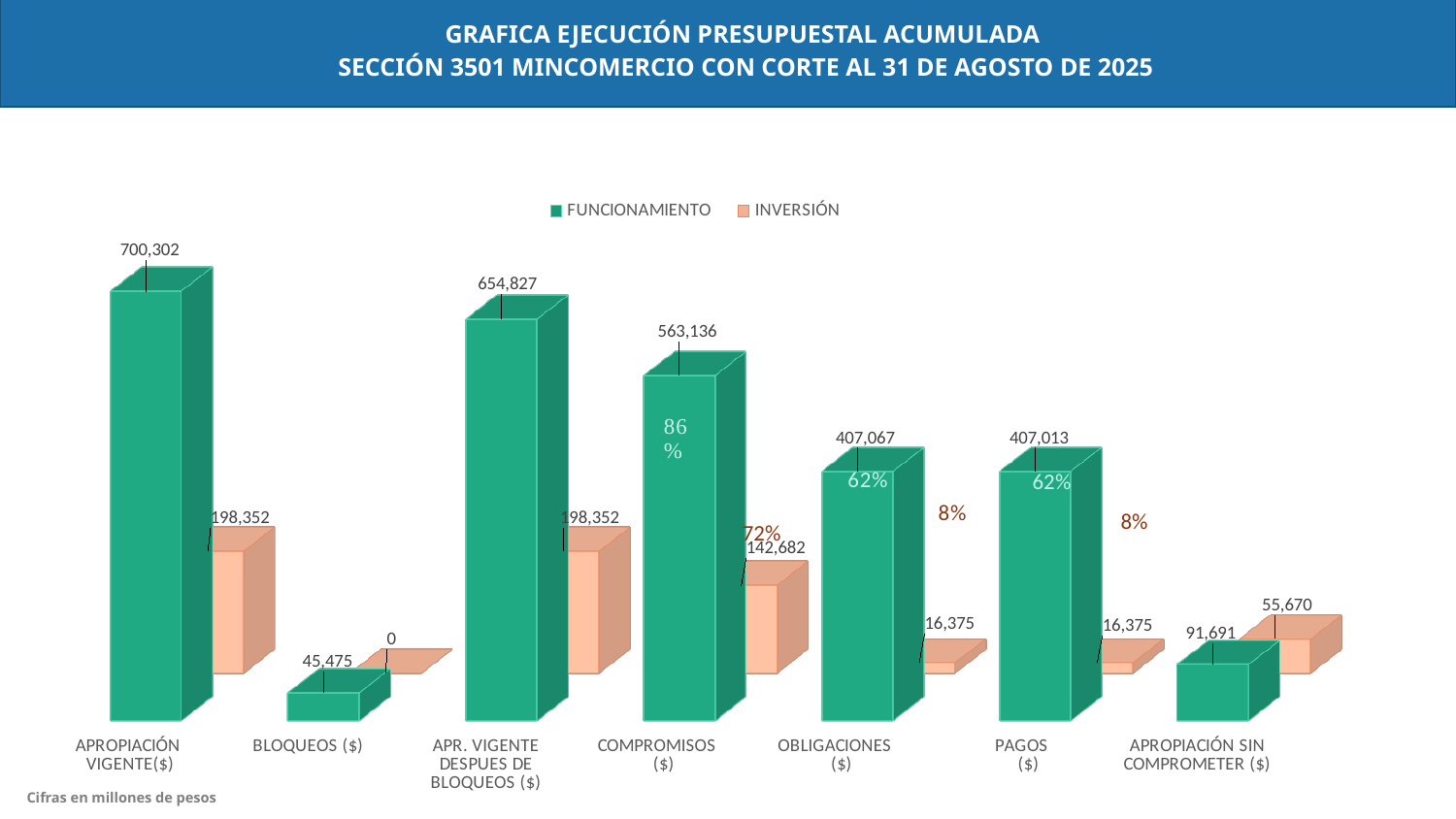
What is the difference between the FUNCIONAMIENTO values for APROPIACIÓN VIGENTE($) and APR. VIGENTE DESPUES DE BLOQUEOS ($)? 45,475 What kind of chart is shown on the slide? Bar chart Which category has the highest FUNCIONAMIENTO value? APROPIACIÓN VIGENTE($) What is the INVERSIÓN value for APROPIACIÓN SIN COMPROMETER ($)? 55,670 What is the FUNCIONAMIENTO value for APROPIACIÓN VIGENTE($)? 700,302 Which is larger: the FUNCIONAMIENTO value for COMPROMISOS ($) or the FUNCIONAMIENTO value for OBLIGACIONES ($)? COMPROMISOS ($) What is the INVERSIÓN value for COMPROMISOS ($)? 142,682 Which series is shown in green in the legend? FUNCIONAMIENTO Which category has the lowest INVERSIÓN value? BLOQUEOS ($) How many series does the legend list? 2 What is the FUNCIONAMIENTO value for BLOQUEOS ($)? 45,475 How many categories are shown on the x axis? 7